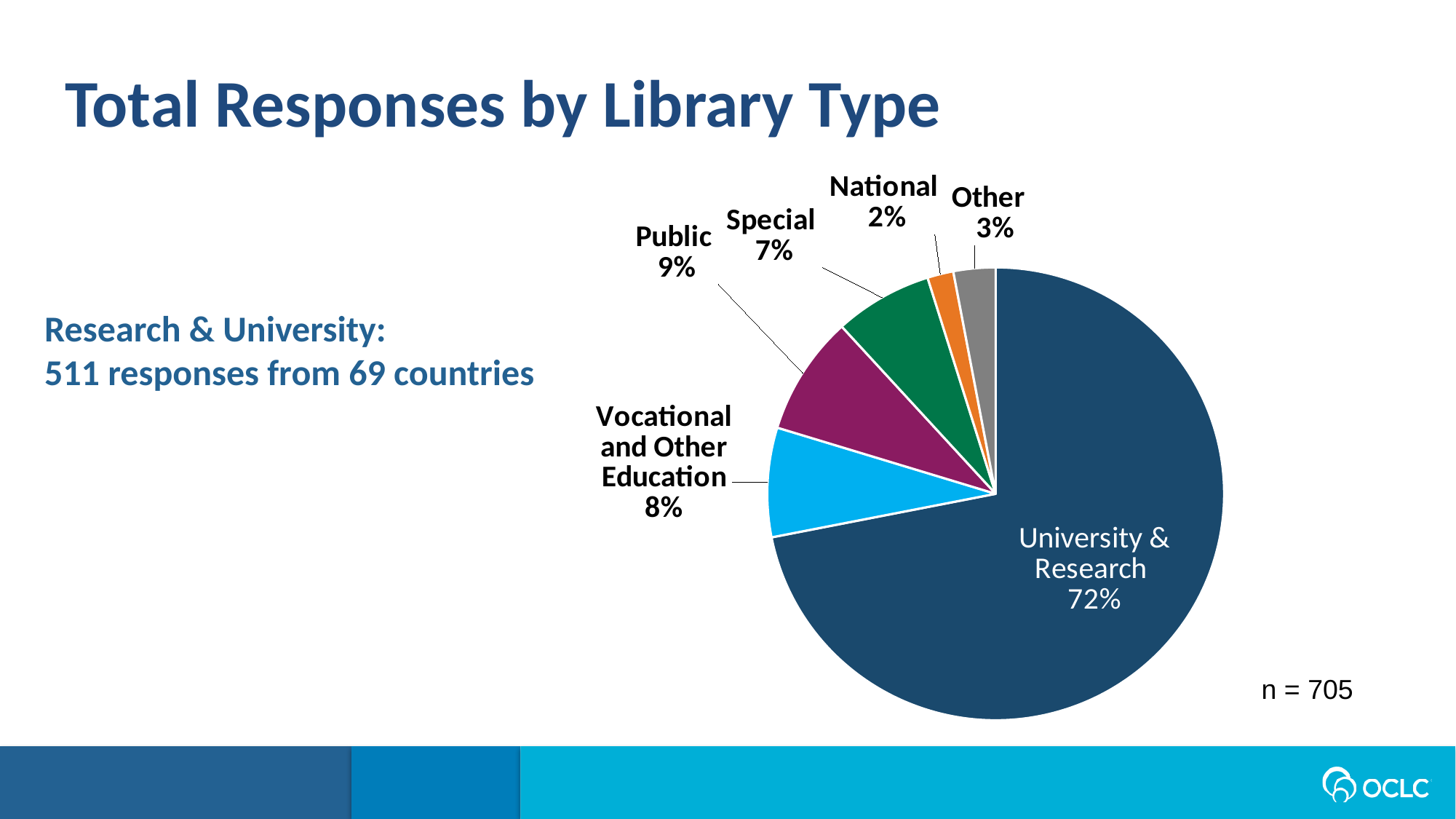
What percentage of responses is from Public libraries? 9% What is the difference in percentage points between the Public and Special slices? 2 Which library type has the smallest share of responses? National Which slice is larger, Other or National? Other What share of total responses comes from University & Research libraries? 72% What is the title of the chart on the slide? Total Responses by Library Type What is the total number of responses (n) shown on the slide? 705 What kind of chart is shown on the slide? Pie chart What percentage of responses is from Special libraries? 7% How many library types are shown in the pie chart? 6 What percentage of responses is from Vocational and Other Education libraries? 8% Which library type has the largest share of responses? University & Research